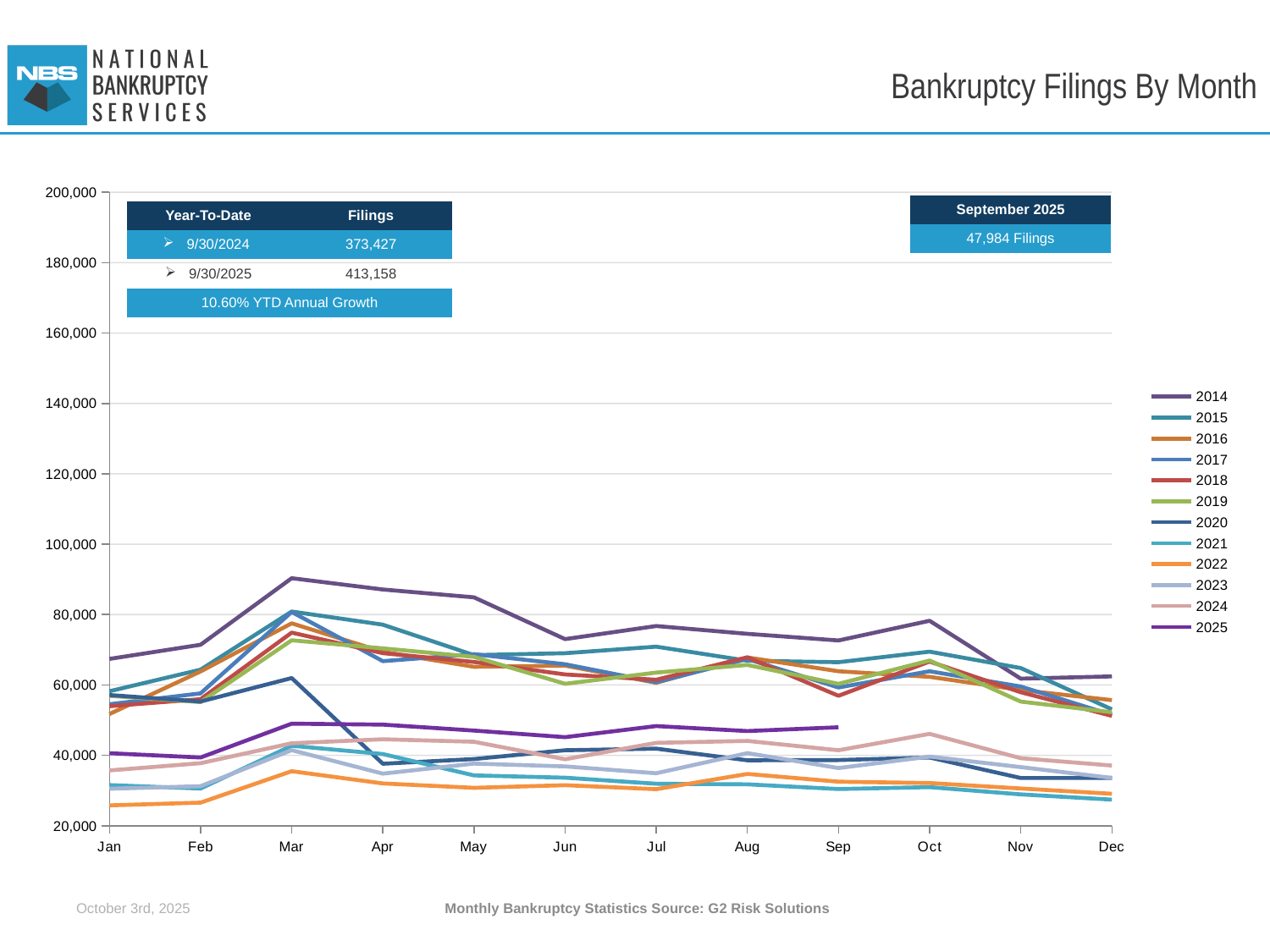
Do the values for 2014 rise or fall from March to June? fall What is the year-to-date filings figure shown for 9/30/2025? 413,158 How many months are shown along the x axis? 12 How many filings does the callout report for September 2025? 47,984 Filings Is the value for 2014 in March greater or less than 80,000? greater What is the title of the chart? Bankruptcy Filings By Month Is the value for 2022 in January greater or less than 40,000? less Which year has the highest value in March? 2014 What kind of chart is shown on the slide? line chart Which year has the lowest value in January? 2022 How many series does the legend list? 12 Which is larger in March, the value for 2014 or the value for 2022? 2014